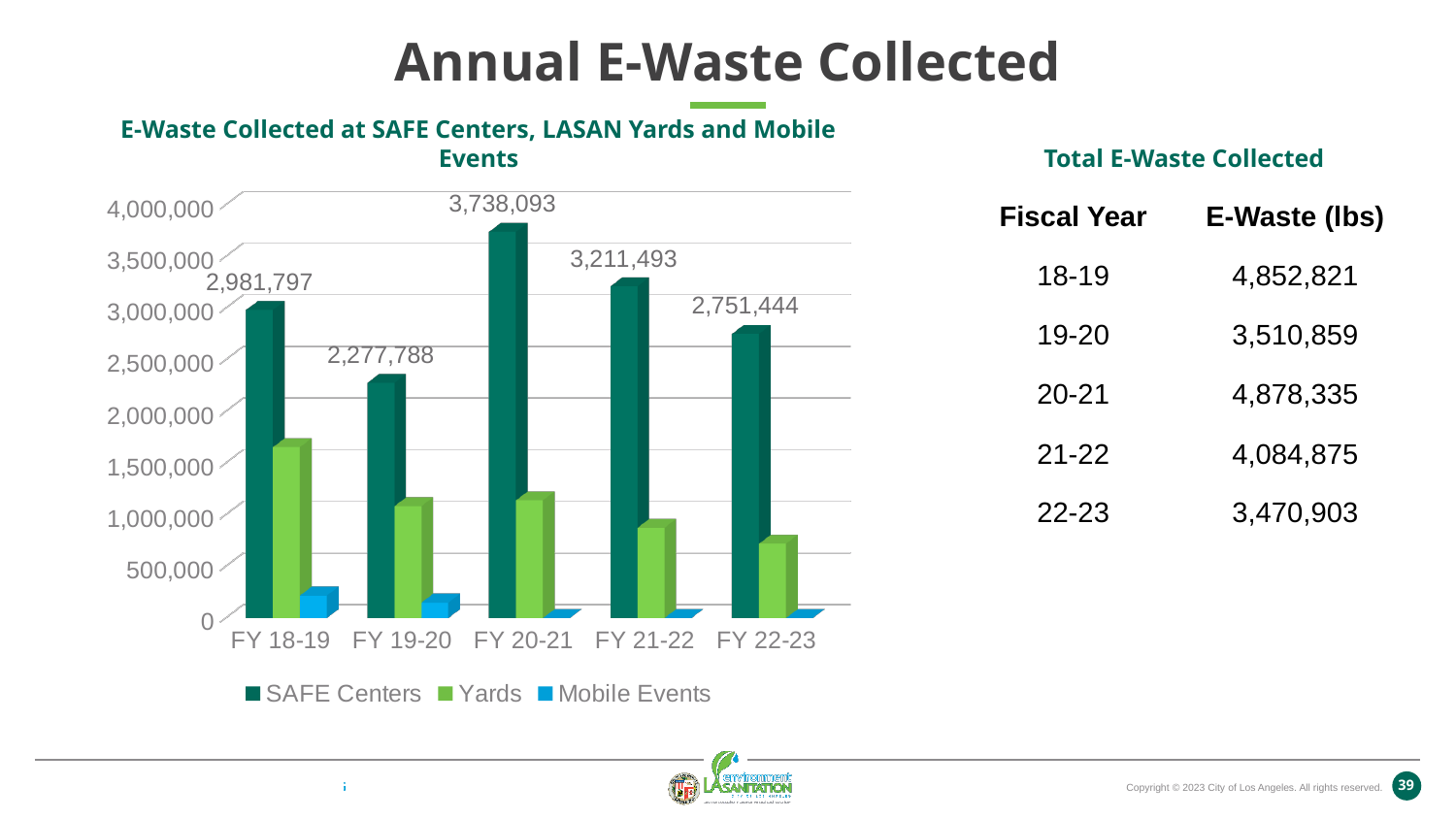
Which is larger, the SAFE Centers value for FY 18-19 or for FY 22-23? FY 18-19 What is the value for SAFE Centers in FY 19-20? 2,277,788 What kind of chart is shown on the slide? Bar chart Which fiscal year has the highest SAFE Centers value? FY 20-21 Is the value for Yards in FY 18-19 greater or less than 1,500,000? greater How many fiscal years are shown on the x axis? 5 How many series does the legend list? 3 Which fiscal year has the lowest SAFE Centers value? FY 19-20 What is the value for SAFE Centers in FY 20-21? 3,738,093 What is the difference between the SAFE Centers values for FY 20-21 and FY 21-22? 526,600 Is the value for Yards in FY 22-23 greater or less than 1,000,000? less What is the value for SAFE Centers in FY 22-23? 2,751,444